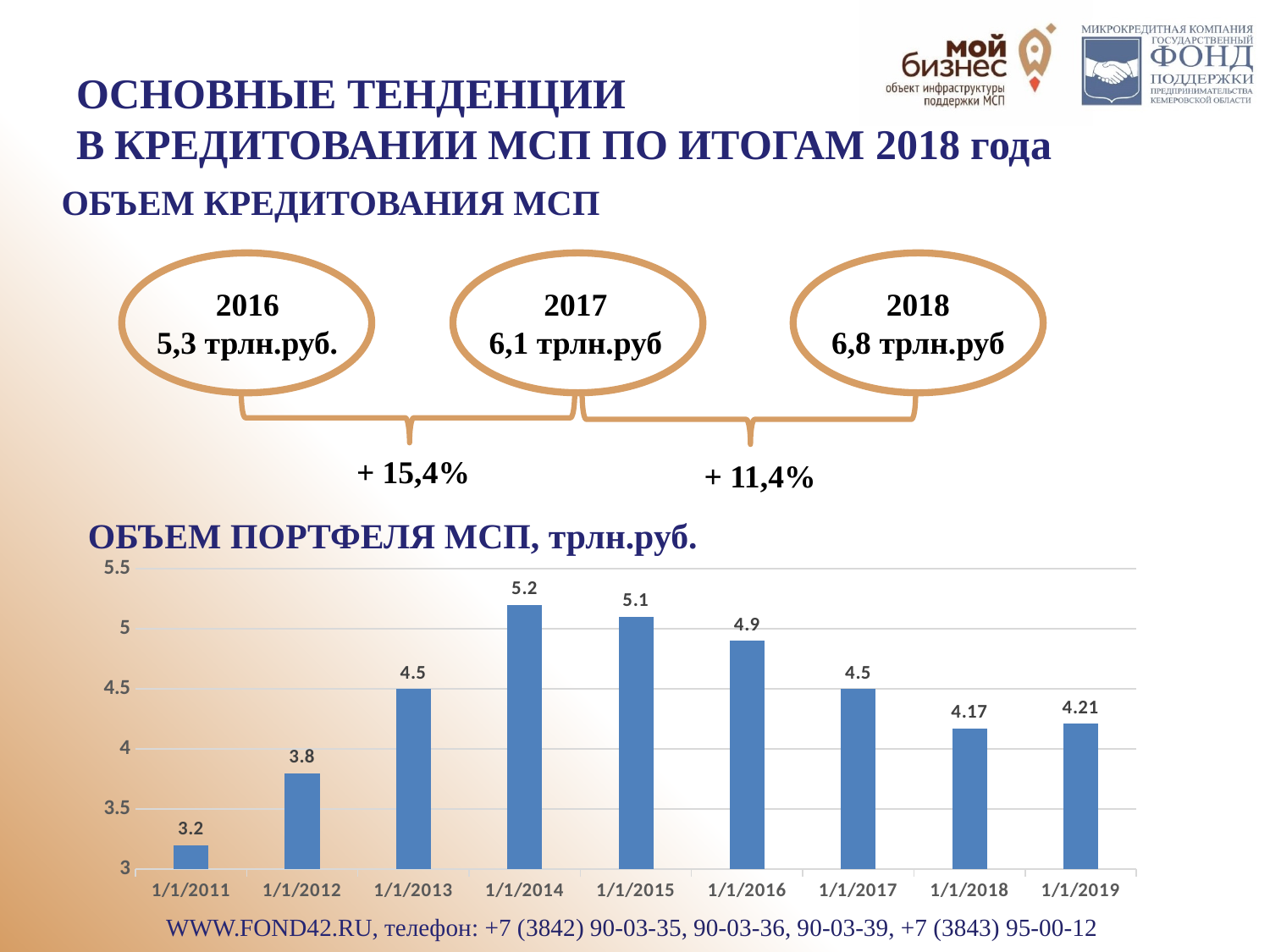
What is the difference between the values for 1/1/2014 and 1/1/2011? 2 How many bars are in the chart? 9 Which category has the lowest value in the chart? 1/1/2011 Is the value for 1/1/2012 greater or less than 4? less What kind of chart is shown on the slide? bar chart Which is larger, the value for 1/1/2015 or the value for 1/1/2016? 1/1/2015 What is the value for 1/1/2011 in the chart? 3.2 What is the value for 1/1/2014 in the chart? 5.2 What is the title of the chart? ОБЪЕМ ПОРТФЕЛЯ МСП, трлн.руб. Which category has the highest value in the chart? 1/1/2014 What is the value for 1/1/2018 in the chart? 4.17 What is the difference between the values for 1/1/2019 and 1/1/2018? 0.04